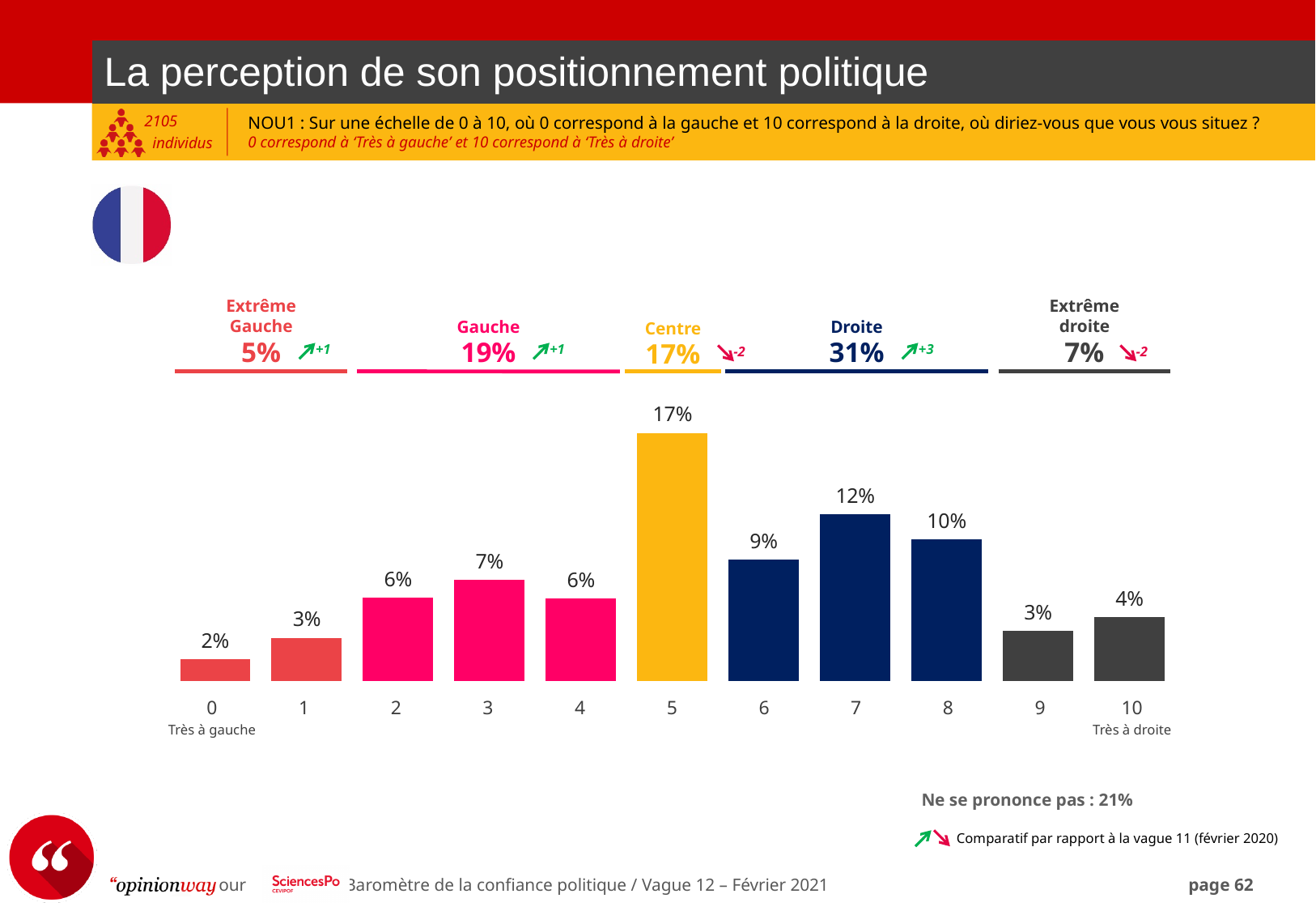
What is the value shown for position 0 (Très à gauche)? 2% What is the difference between the values for position 5 and position 7? 5% Which has a larger value, position 8 or position 6? Position 8 What is the value shown for position 7 on the scale? 12% What is the total percentage shown for the 'Droite' group? 31% What change compared to the previous wave is shown for the 'Centre' group? -2 What is the percentage shown for 'Ne se prononce pas'? 21% What kind of chart is used to show the distribution across the scale? Bar chart Which position on the scale has the highest percentage? 5 How many positions (bars) are shown on the scale? 11 Which position on the scale has the lowest percentage? 0 What percentage of respondents placed themselves at position 5 on the scale? 17%